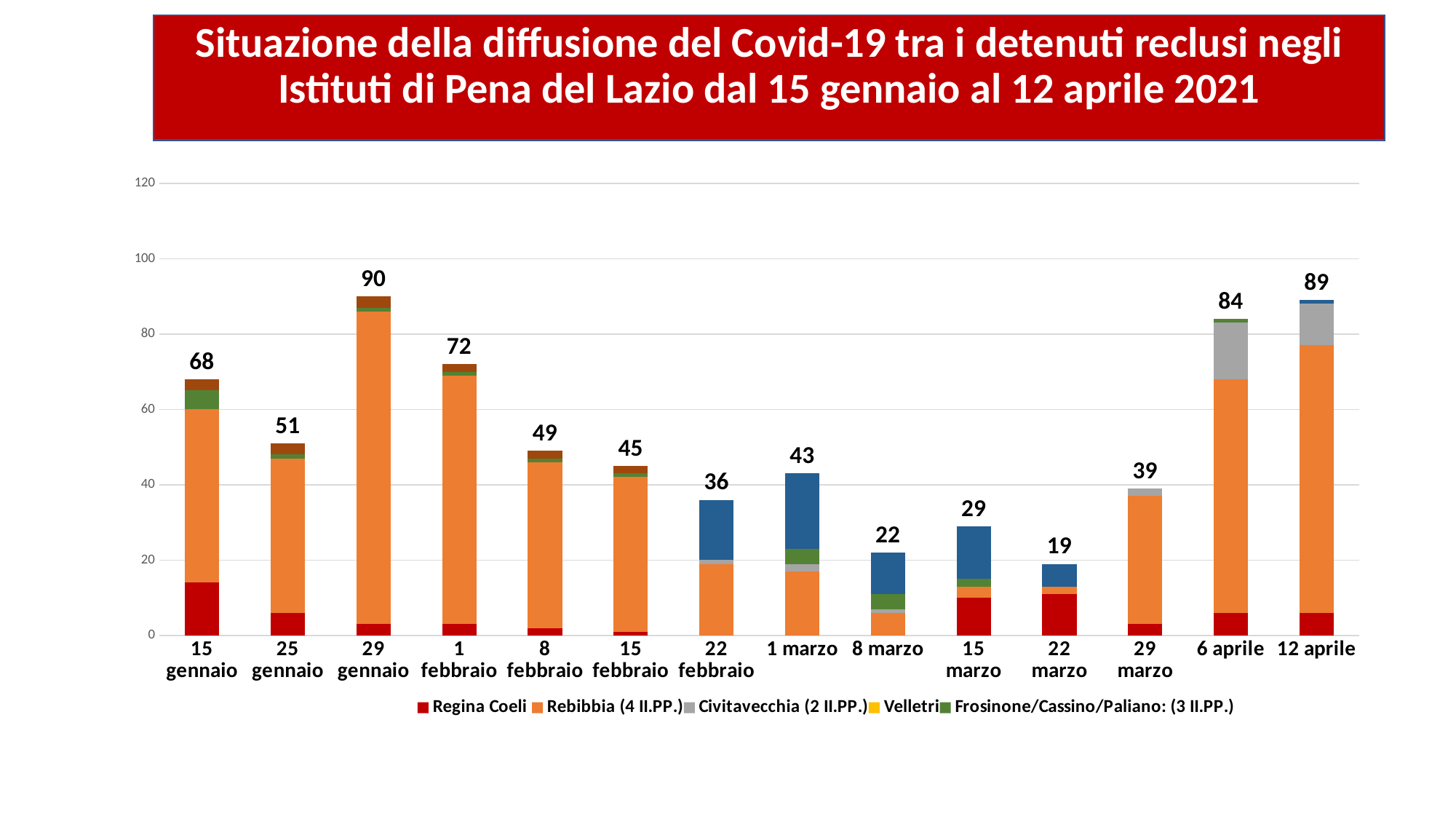
How many series does the legend list? 5 What kind of chart is shown on the slide? Stacked bar chart What is the total value shown for the bar on 29 gennaio? 90 What is the total value shown for the bar on 8 marzo? 22 Is the Regina Coeli value on 15 gennaio greater or less than 20? less What is the difference between the totals for 29 gennaio and 22 marzo? 71 How many dates are shown on the x axis? 14 What is the difference between the totals for 12 aprile and 6 aprile? 5 Do the totals rise or fall from 29 gennaio to 22 marzo? Fall Which date has the lowest total? 22 marzo Which total is larger, 15 gennaio or 1 febbraio? 1 febbraio Which date has the highest total? 29 gennaio